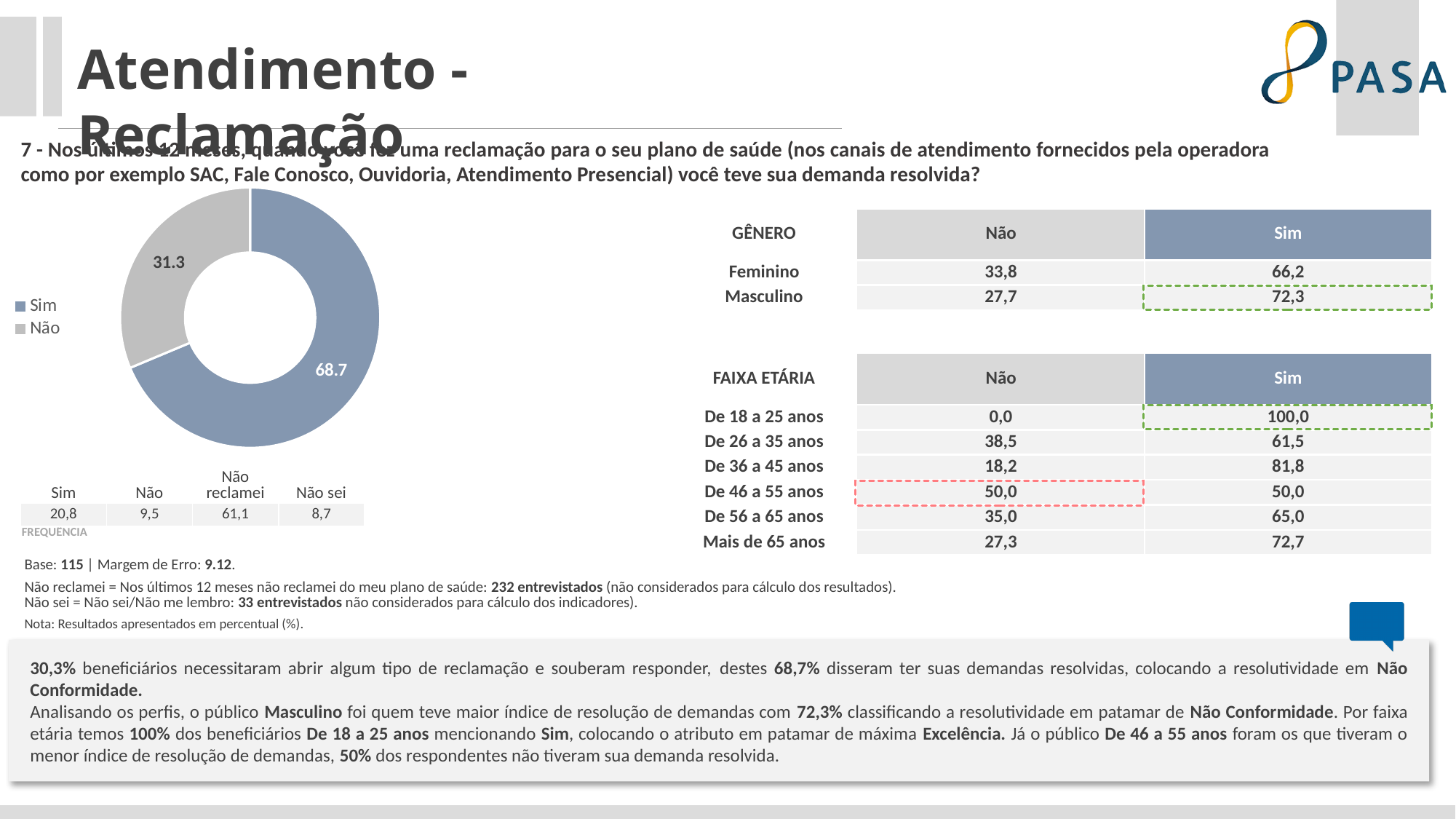
What value is shown for the Sim slice of the donut chart? 68.7 What colour is the Sim slice in the donut chart? Blue What is the difference between the Sim and Não values in the donut chart? 37.4 In the donut chart, is the value for Sim larger or smaller than the value for Não? larger What value is shown for the Não slice of the donut chart? 31.3 What share of the donut chart does the Sim slice represent? 68.7 Which slice of the donut chart is the smallest? Não How many entries does the legend of the donut chart list? 2 What kind of chart is shown on the left of the slide? Donut (pie) chart Which slice of the donut chart is the largest? Sim How many slices does the donut chart have? 2 What are the two legend entries of the donut chart? Sim and Não